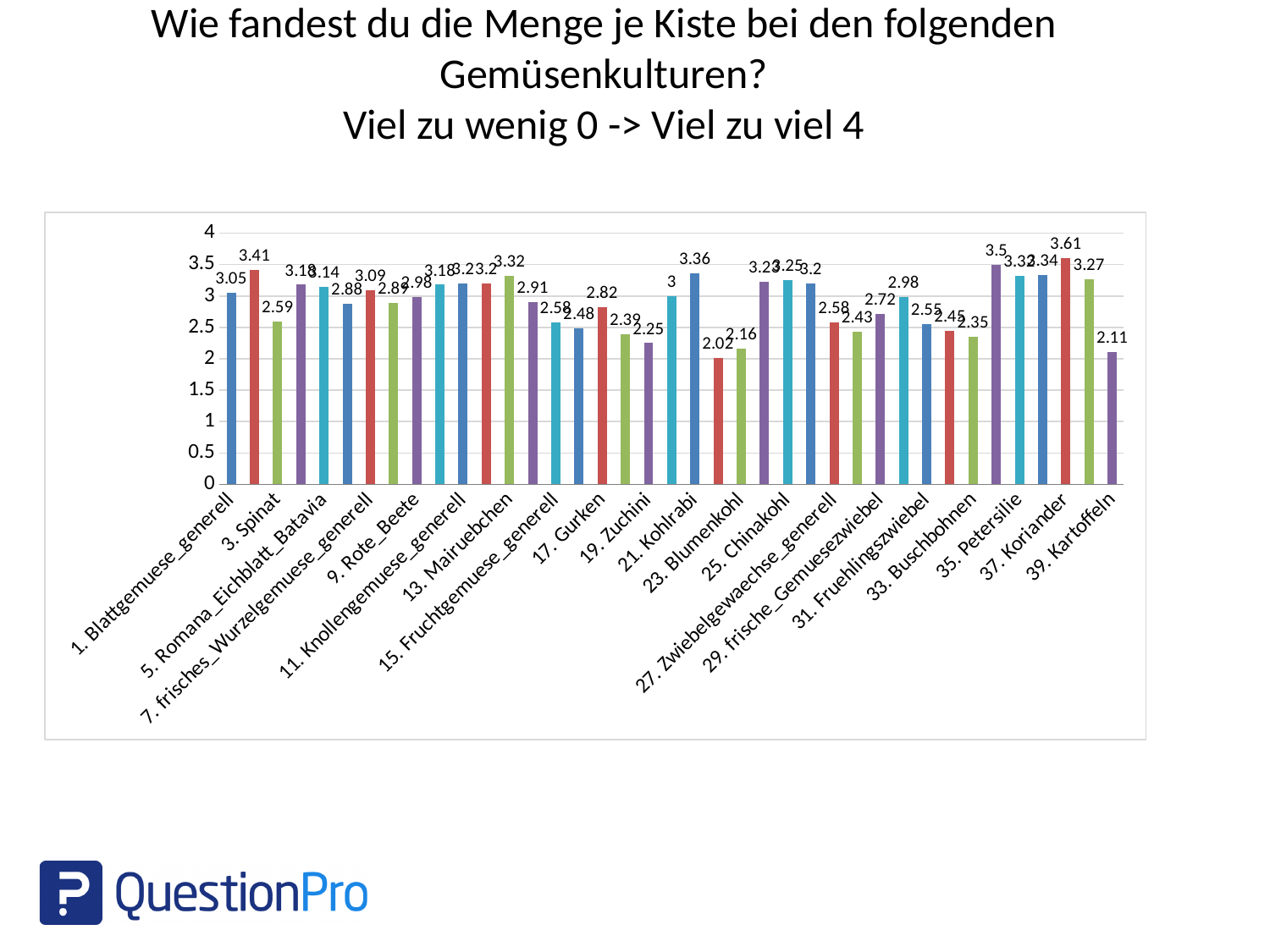
Which has the larger value, 3. Spinat or 17. Gurken? 17. Gurken Is the value for 23. Blumenkohl greater or less than 2.5? less What is the value for 3. Spinat? 2.59 What is the value for 37. Koriander? 3.61 What is the value for 13. Mairuebchen? 3.32 Which labelled category has the highest value? 37. Koriander What is the difference between the values for 21. Kohlrabi and 19. Zuchini? 1.11 What is the maximum value shown on the vertical axis? 4 What is the difference between the values for 37. Koriander and 39. Kartoffeln? 1.5 What is the value for 21. Kohlrabi? 3.36 What is the value for 39. Kartoffeln? 2.11 What kind of chart is shown on the slide? bar chart